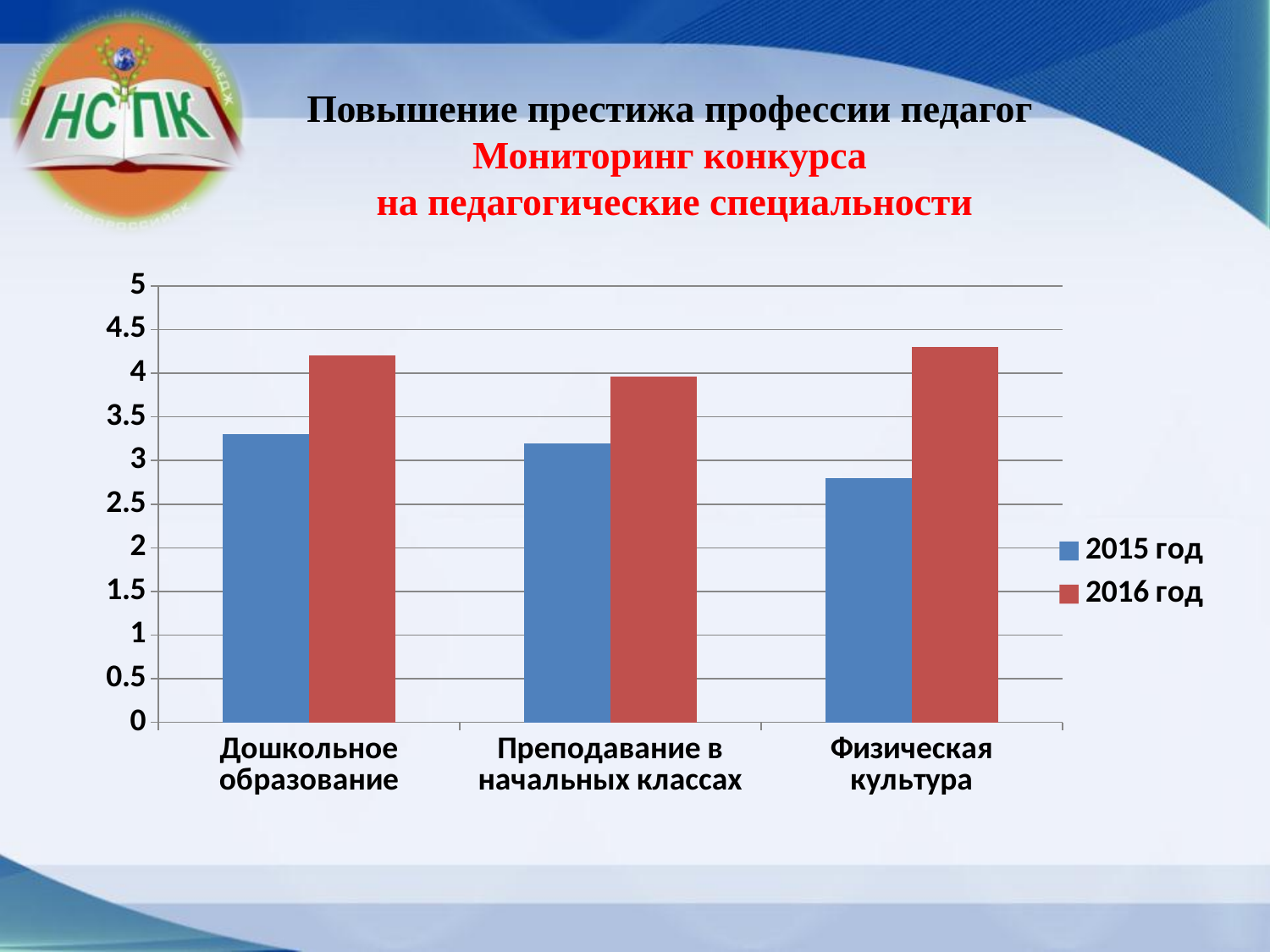
Is the value for Преподавание в начальных классах in 2015 год greater or less than 3? greater Is the value for Физическая культура in 2015 год greater or less than 3? less Is the value for Физическая культура in 2016 год greater or less than 4? greater Which category has the lowest value for 2015 год? Физическая культура How many categories are shown on the x axis? 3 For Физическая культура, which series has the larger value, 2015 год or 2016 год? 2016 год How many series does the legend list? 2 What kind of chart is shown on the slide? bar chart For Преподавание в начальных классах, which series has the larger value, 2015 год or 2016 год? 2016 год Which colour represents the 2016 год series in the chart? red